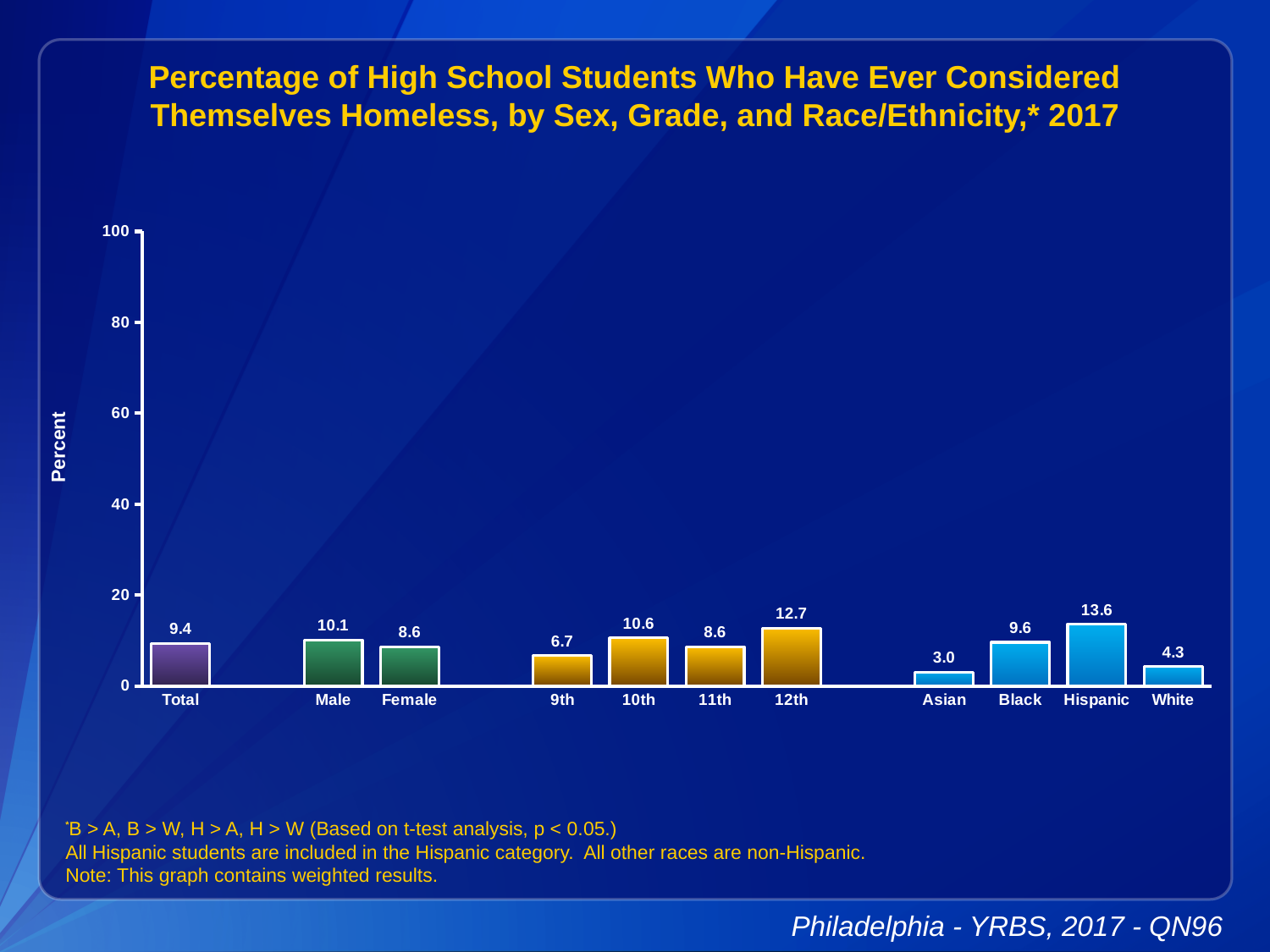
Which is larger, the value for 12th grade or the value for 10th grade? 12th How many categories are shown on the x axis? 11 What is the difference between the values for Hispanic and White students? 9.3 What is the label on the y axis? Percent What is the difference between the values for Male and Female? 1.5 What kind of chart is this? bar chart What is the value for Hispanic students? 13.6 Which category has the lowest value? Asian Is the value for Black students greater or less than 20? less Which category has the highest value? Hispanic What is the value for Total? 9.4 What is the value for 9th grade students? 6.7